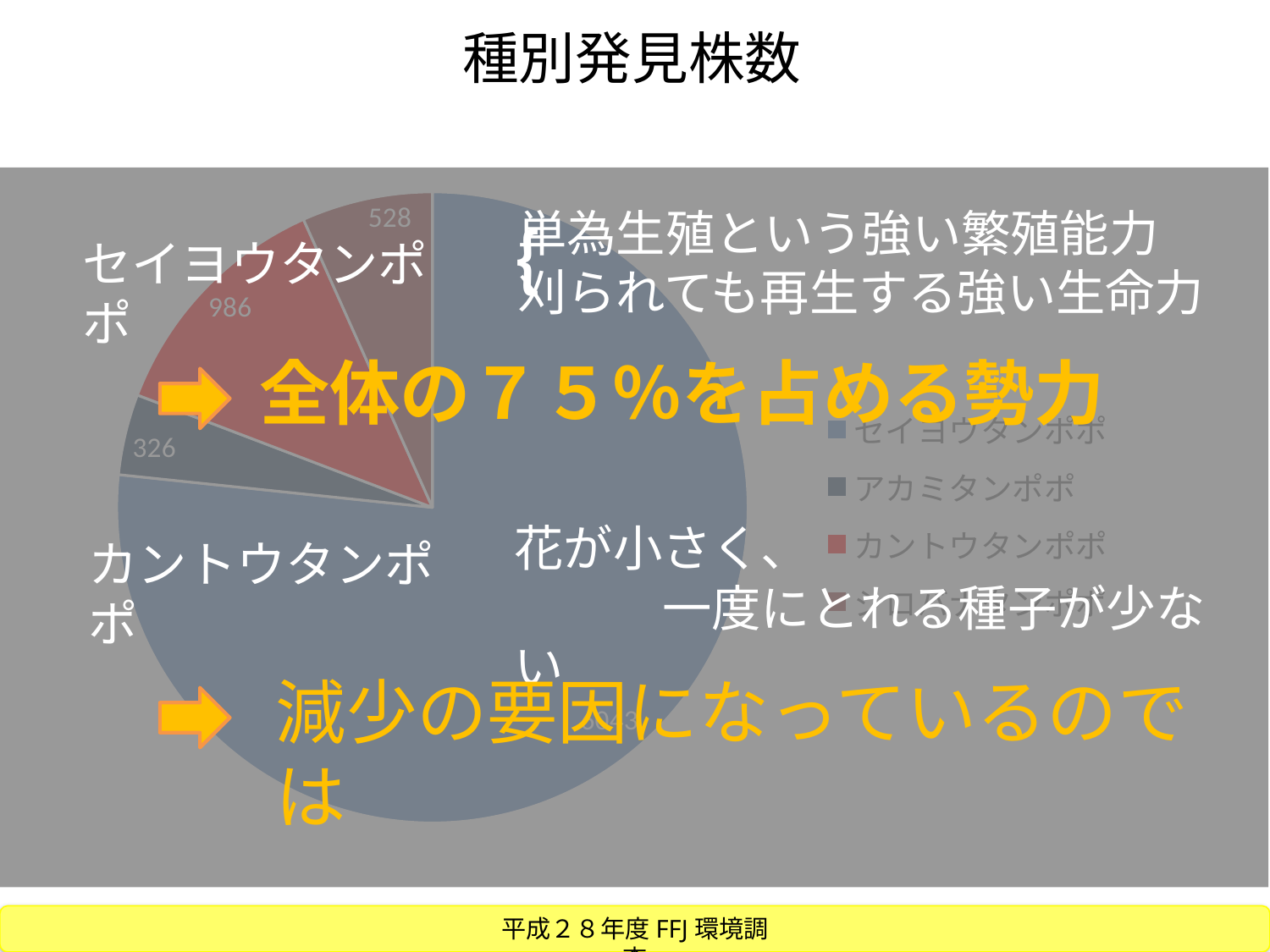
Which is larger, the value for カントウタンポポ or the value for アカミタンポポ? カントウタンポポ What value is shown for カントウタンポポ? 986 What is the difference between the values for カントウタンポポ and アカミタンポポ? 660 What colour is the slice for カントウタンポポ? red What kind of chart is shown on the slide? pie chart Which category has the smallest slice of the pie? アカミタンポポ What is the title of the chart? 種別発見株数 How many slices does the pie chart have? 4 What value is shown for アカミタンポポ? 326 Which category has the largest slice of the pie? セイヨウタンポポ